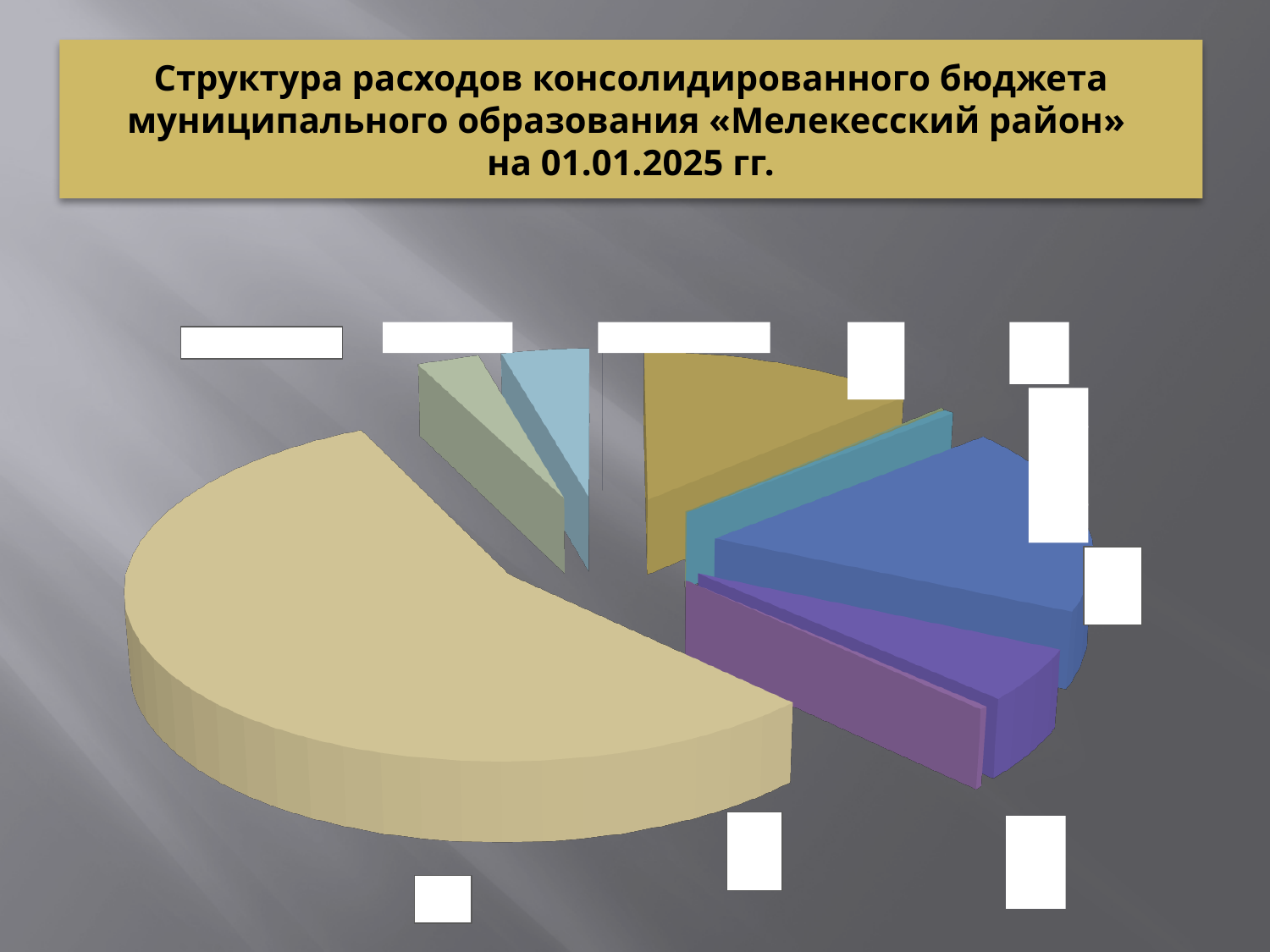
What is the title of the chart on the slide? Структура расходов консолидированного бюджета муниципального образования «Мелекесский район» на 01.01.2025 гг. Does the largest slice of the pie chart take up more or less than half of the pie? more Which colour slice takes up the largest share of the pie chart? the beige slice What kind of chart is shown on the slide? pie chart How many slices does the pie chart have? 7